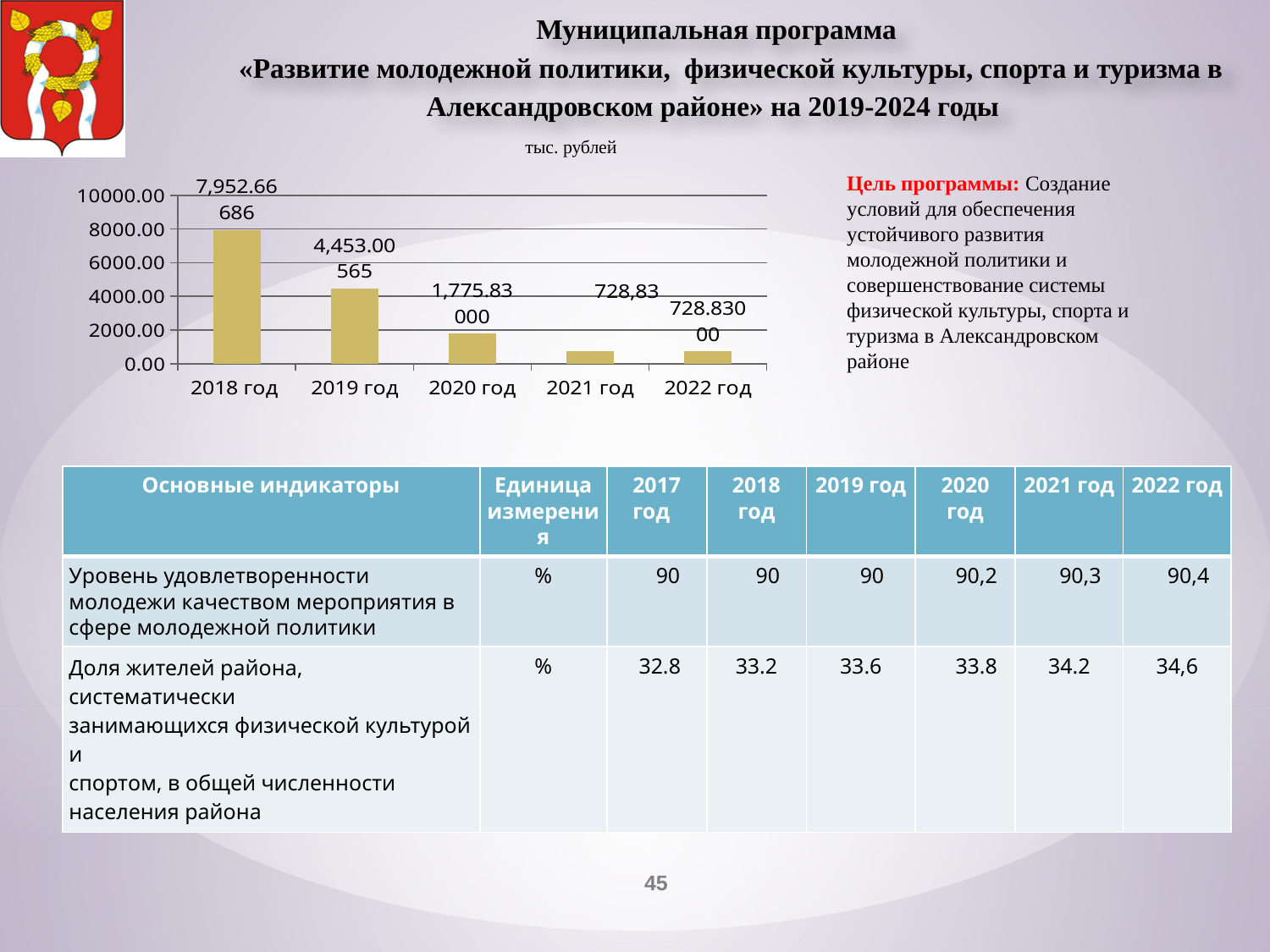
Which year has the highest bar on the chart? 2018 год What kind of chart is shown on the slide? bar chart How many year categories are plotted on the bar chart? 5 What unit of measurement is written above the chart? тыс. рублей Is the value for 2019 год greater or less than 4000.00? greater Which is larger, the value for 2018 год or the value for 2019 год? 2018 год What value is labelled on the bar for 2021 год? 728,83 Is the value for 2018 год greater or less than 6000.00? greater Is the value for 2022 год greater or less than 2000.00? less Do the values on the chart rise or fall from 2018 год to 2021 год? fall Which is larger, the value for 2020 год or the value for 2021 год? 2020 год